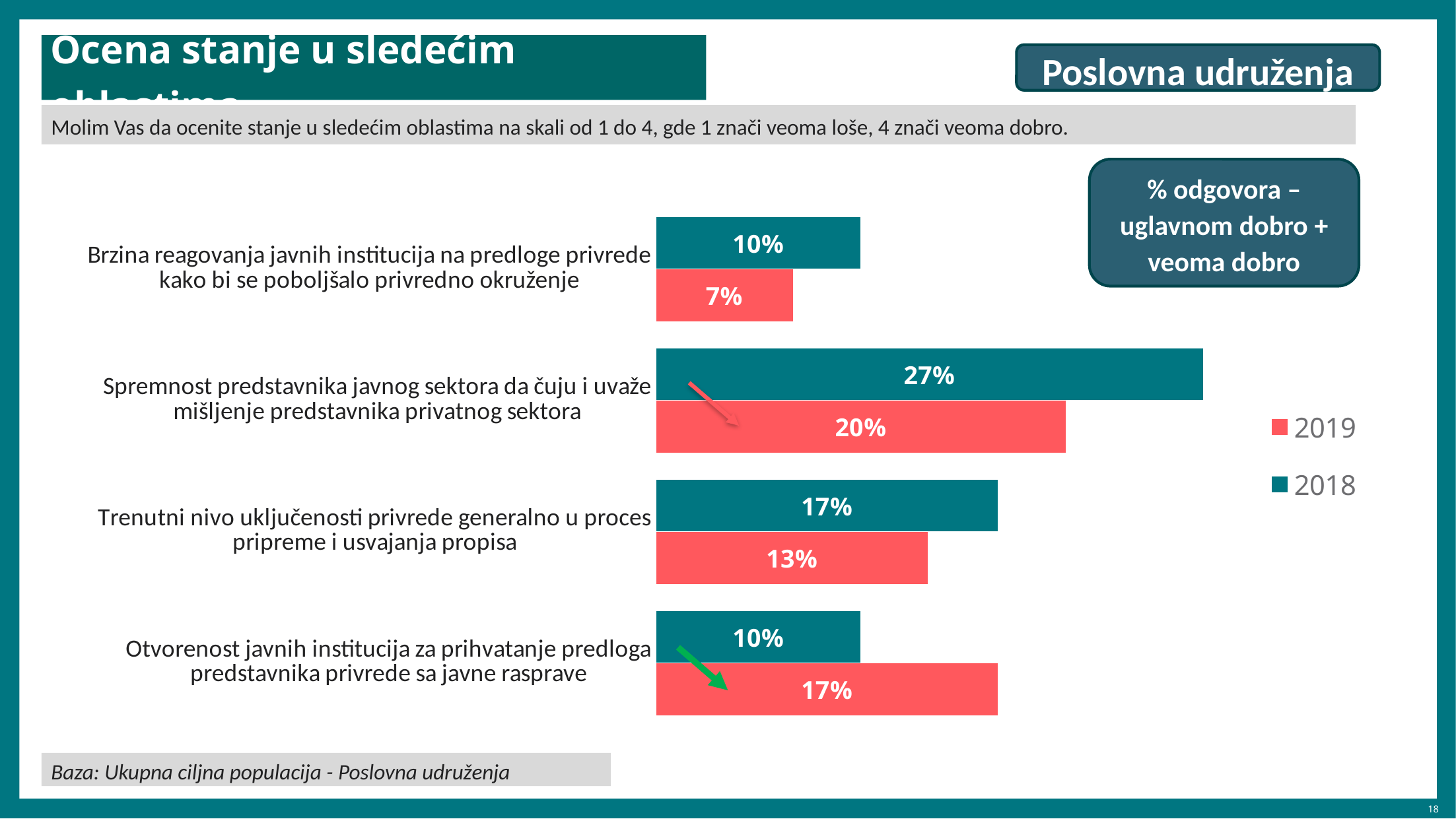
What is the 2018 value for "Otvorenost javnih institucija za prihvatanje predloga predstavnika privrede sa javne rasprave"? 10% Which colour represents the 2019 series in the legend? Red Which category has the highest 2018 value? Spremnost predstavnika javnog sektora da čuju i uvaže mišljenje predstavnika privatnog sektora What is the 2019 value for "Spremnost predstavnika javnog sektora da čuju i uvaže mišljenje predstavnika privatnog sektora"? 20% How many series does the legend list? 2 For "Otvorenost javnih institucija za prihvatanje predloga predstavnika privrede sa javne rasprave", which year has the larger value, 2018 or 2019? 2019 How many categories are shown in the chart? 4 What is the 2019 value for "Brzina reagovanja javnih institucija na predloge privrede kako bi se poboljšalo privredno okruženje"? 7% What is the 2018 value for "Trenutni nivo uključenosti privrede generalno u proces pripreme i usvajanja propisa"? 17% What is the difference between the 2018 and 2019 values for "Spremnost predstavnika javnog sektora da čuju i uvaže mišljenje predstavnika privatnog sektora"? 7% Which category has the lowest 2019 value? Brzina reagovanja javnih institucija na predloge privrede kako bi se poboljšalo privredno okruženje What kind of chart is shown on the slide? Bar chart